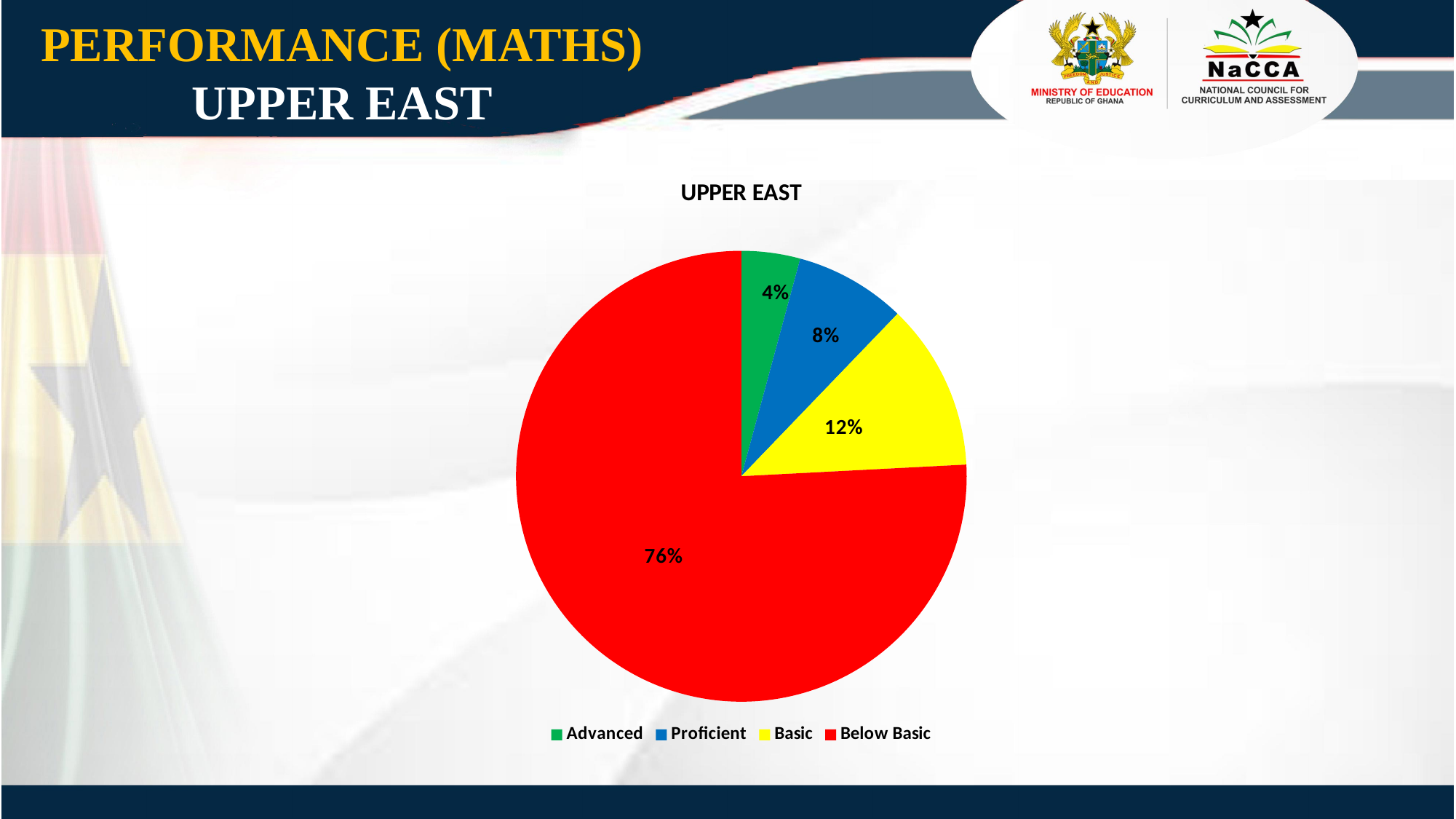
What share of the pie is Advanced? 4% How many categories does the pie chart show? 4 What share of the pie is Proficient? 8% What share of the pie is Basic? 12% What is the title of the chart? UPPER EAST What kind of chart is shown on the slide? Pie chart What is the difference between the Below Basic and Basic shares? 64% Which category has the largest slice of the pie? Below Basic Which category has the smallest slice of the pie? Advanced Which is larger, the Proficient slice or the Basic slice? Basic What is the difference between the Basic and Proficient shares? 4%